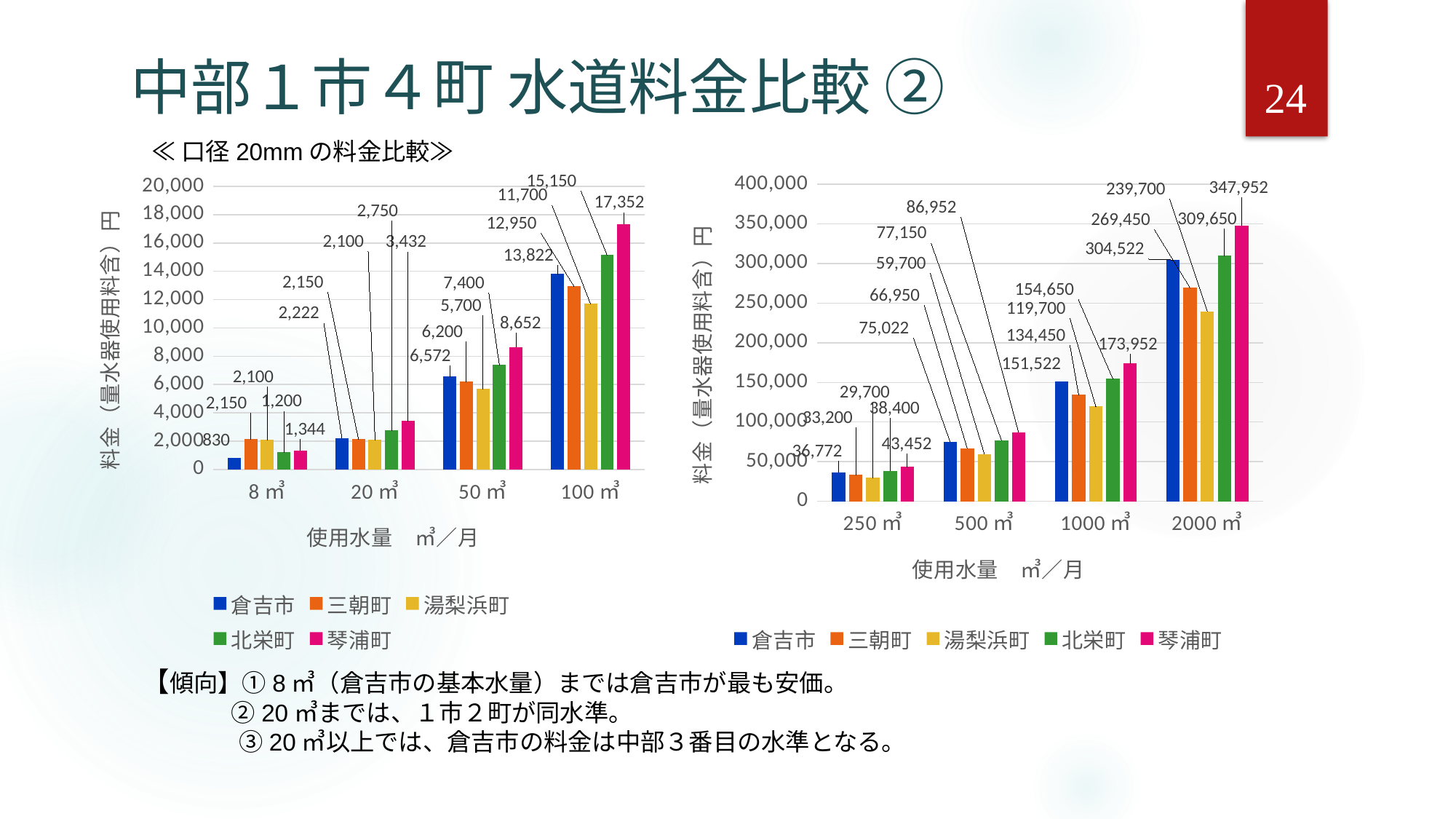
In the right chart, which municipality has the highest value at 2000㎥? 琴浦町 In the left chart, which municipality has the lowest value at 8㎥? 倉吉市 What kind of chart is the left chart (8㎥–100㎥)? bar chart How many series does the legend of the right chart (250㎥–2000㎥) list? 5 In the left chart, what is the value for 琴浦町 at 100㎥? 17,352 In the right chart, is the value for 琴浦町 at 2000㎥ greater or less than 300,000? greater In the left chart, what is the value for 倉吉市 at 8㎥? 830 How many usage-volume categories are shown on the x axis of the left chart? 4 In the right chart, what is the value for 琴浦町 at 2000㎥? 347,952 In the left chart, do the values for 琴浦町 rise or fall as usage volume increases along the x axis? rise In the left chart, what is the difference between 琴浦町 and 湯梨浜町 at 100㎥? 5,652 In the right chart, which is larger at 1000㎥: 倉吉市 or 三朝町? 倉吉市